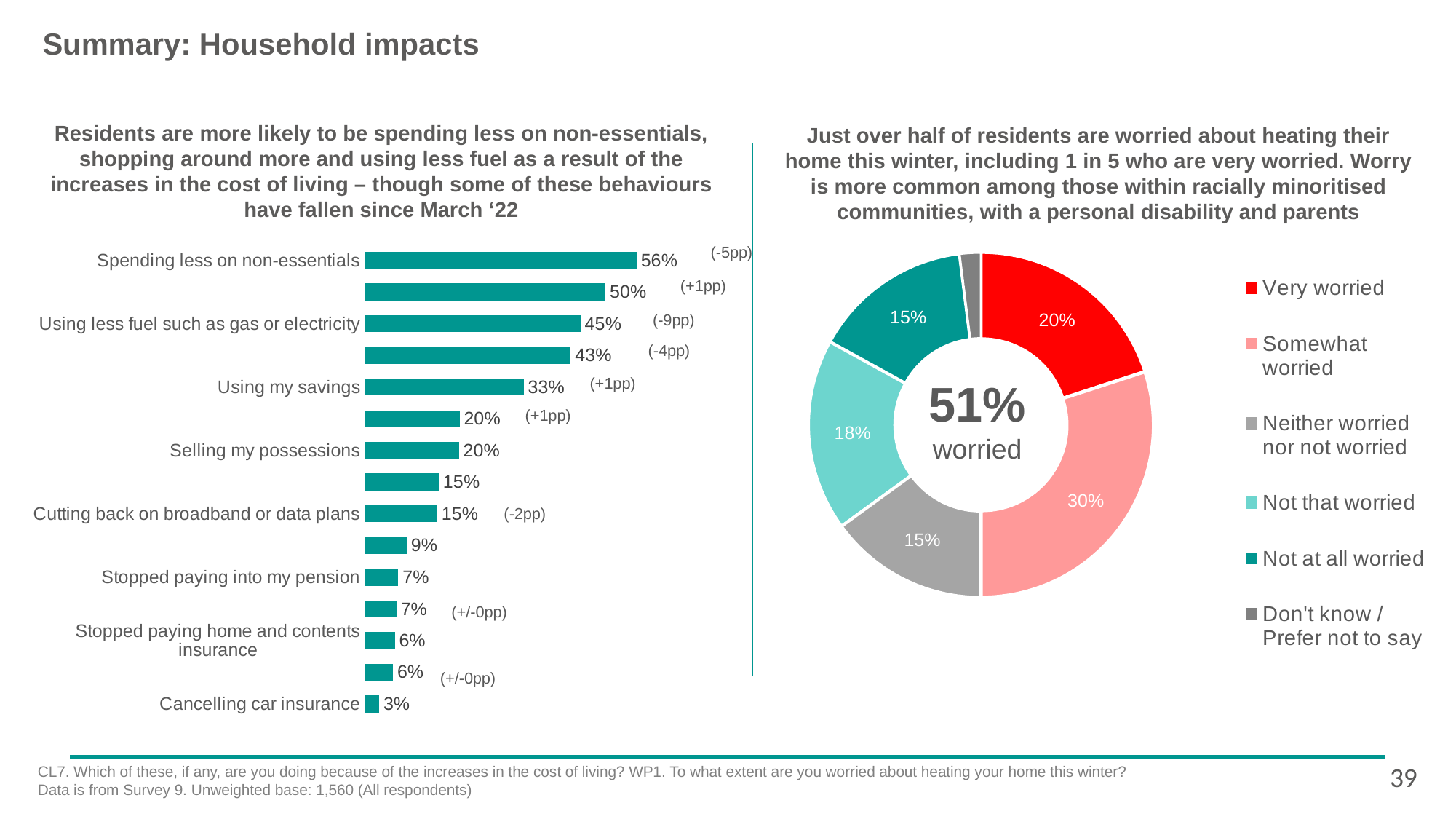
In the bar chart on the left, which category has the lowest value? Cancelling car insurance In the bar chart on the left, what is the value for 'Using my savings'? 33% How many entries does the legend of the donut chart on the right list? 6 How many bars are plotted in the bar chart on the left? 15 What type of chart is shown on the left of the slide? Bar chart In the bar chart on the left, which category has the highest value? Spending less on non-essentials In the bar chart on the left, what percentage of residents are spending less on non-essentials? 56% In the donut chart on the right, what share of residents are 'Somewhat worried'? 30% In the bar chart on the left, what is the value for 'Cancelling car insurance'? 3% In the bar chart on the left, what is the value for 'Using less fuel such as gas or electricity'? 45% In the bar chart on the left, what is the difference between 'Spending less on non-essentials' and 'Using my savings'? 23% In the bar chart on the left, which is larger: 'Selling my possessions' or 'Stopped paying into my pension'? Selling my possessions